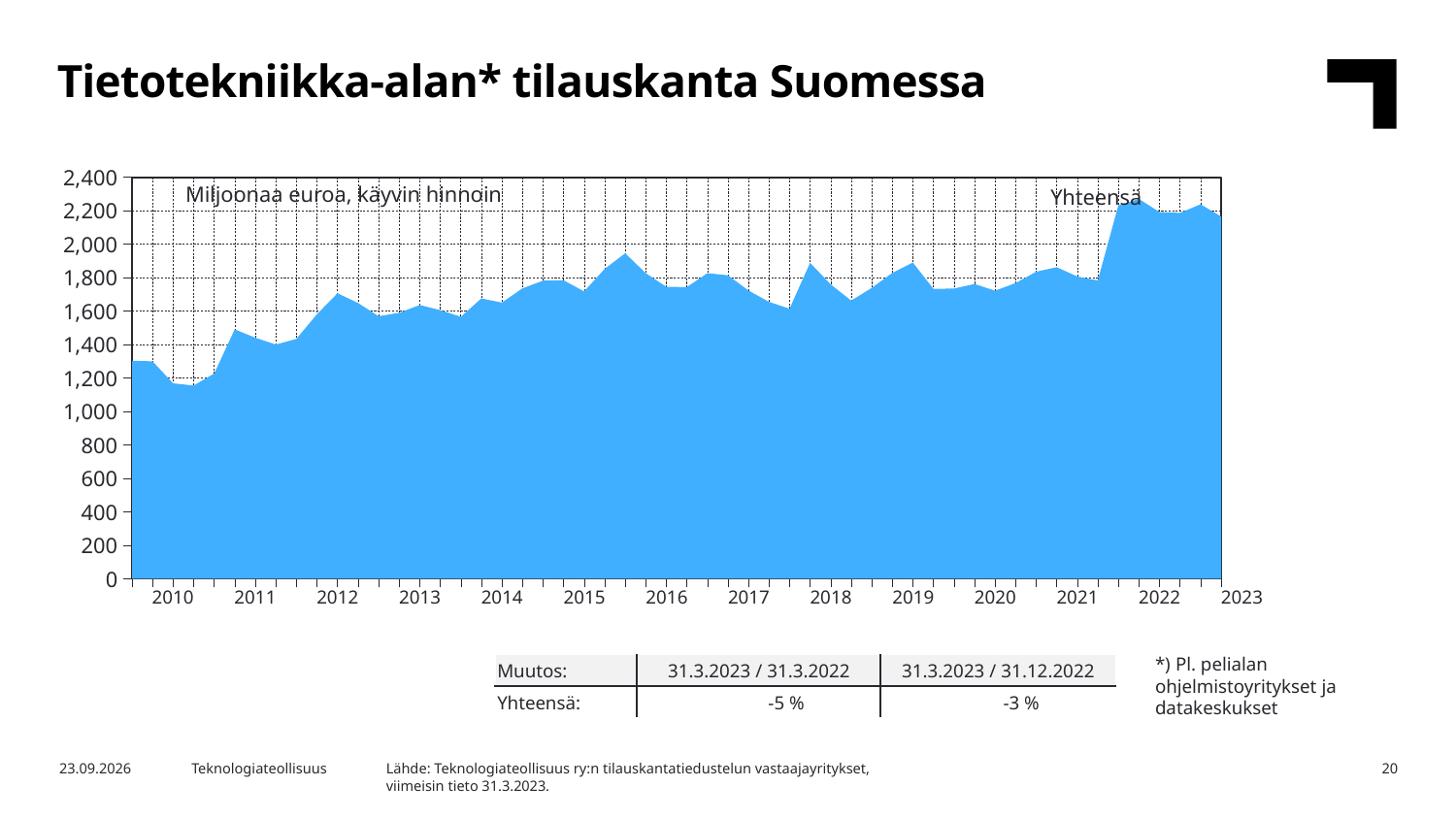
In which year does the series reach its lowest value? 2010 Is the value in 2019 greater or less than 1,600? greater Is the value in 2016 greater or less than 2,000? less What kind of chart is shown on the slide? Area chart What unit is the chart's data expressed in, according to the label inside the plot area? Miljoonaa euroa, käyvin hinnoin Is the value at the start of 2010 greater or less than 1,400? less Which is larger, the value in 2022 or the value in 2010? 2022 What is the title of the chart on the slide? Tietotekniikka-alan* tilauskanta Suomessa In which year does the series reach its highest value? 2022 Overall, does the series rise or fall from 2010 to 2023? rise